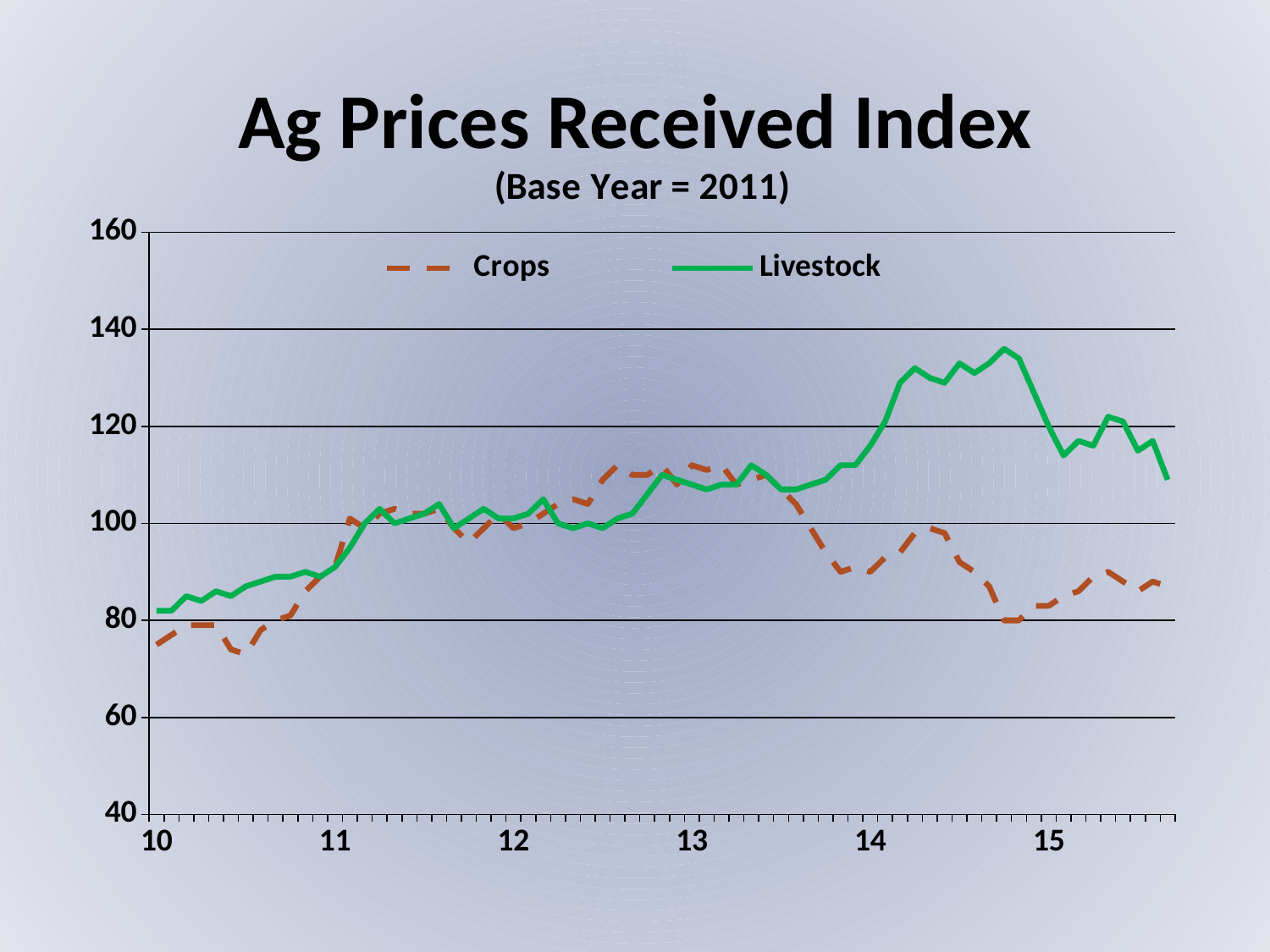
What is the title of the chart? Ag Prices Received Index In mid-2012, which series has the higher value, Crops or Livestock? Crops What base year does the subtitle say the index uses? 2011 How many series does the legend list? 2 Is the value of the Crops series at the start of 2010 greater or less than 80? less Is the peak value of the Livestock series in late 2014 greater or less than 140? less Which series reaches the highest value anywhere on the chart? Livestock Is the peak value of the Livestock series in late 2014 greater or less than 120? greater Does the Livestock series rise or fall between the start of 2010 and the start of 2011? rise At the start of 2015, which series has the higher value, Crops or Livestock? Livestock What kind of chart is shown on the slide? line chart